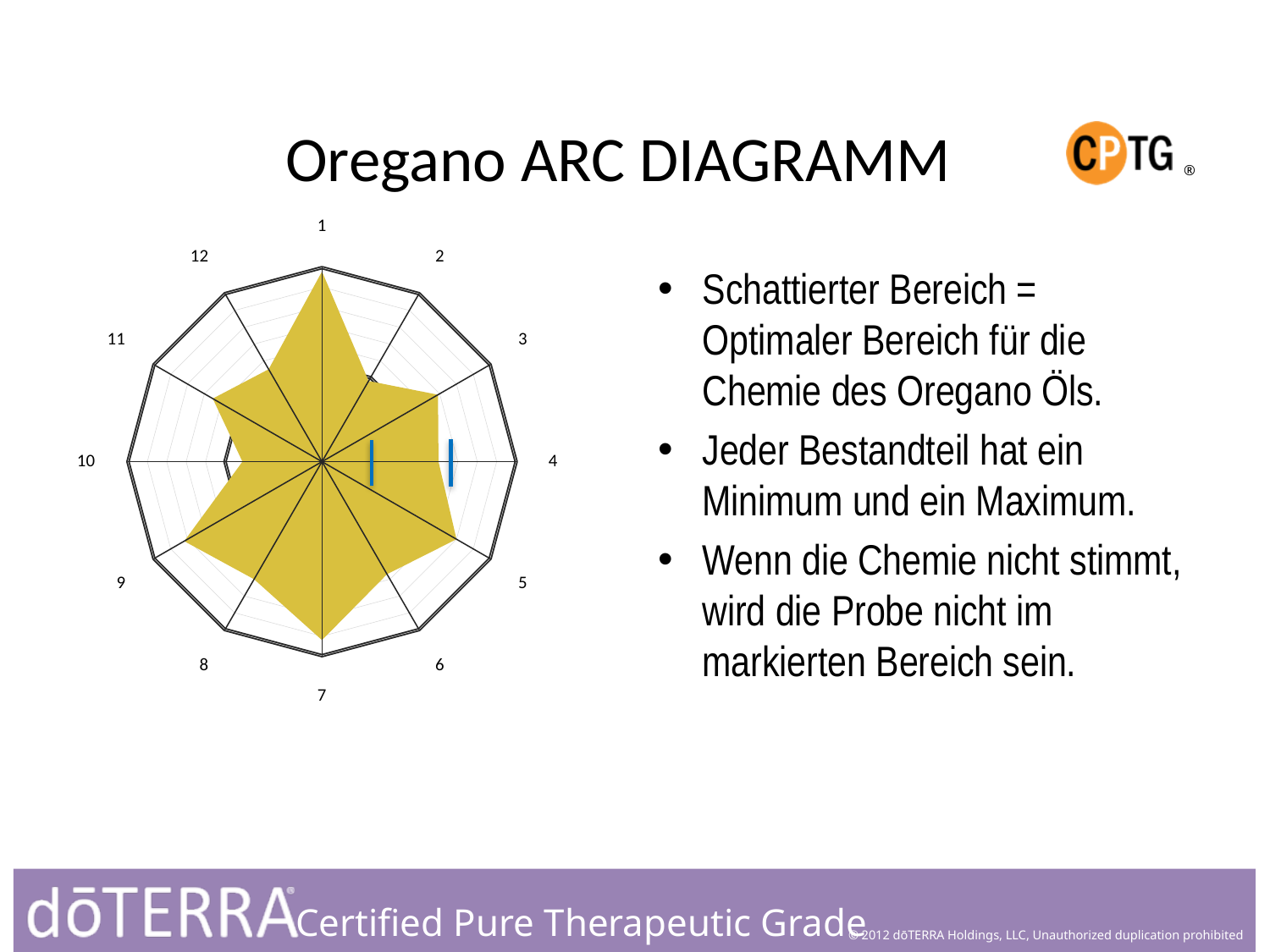
Which category has the smallest shaded extent in the radar chart? 10 In the radar chart, which extends further from the centre: category 9 or category 2? Category 9 What kind of chart is shown on the slide? Radar chart How many categories are plotted around the radar chart? 12 In the radar chart, which extends further from the centre: category 7 or category 12? Category 7 What is the title of the slide containing the radar chart? Oregano ARC DIAGRAMM In the radar chart, which extends further from the centre: category 4 or category 10? Category 4 What colour is the shaded area in the radar chart? Yellow